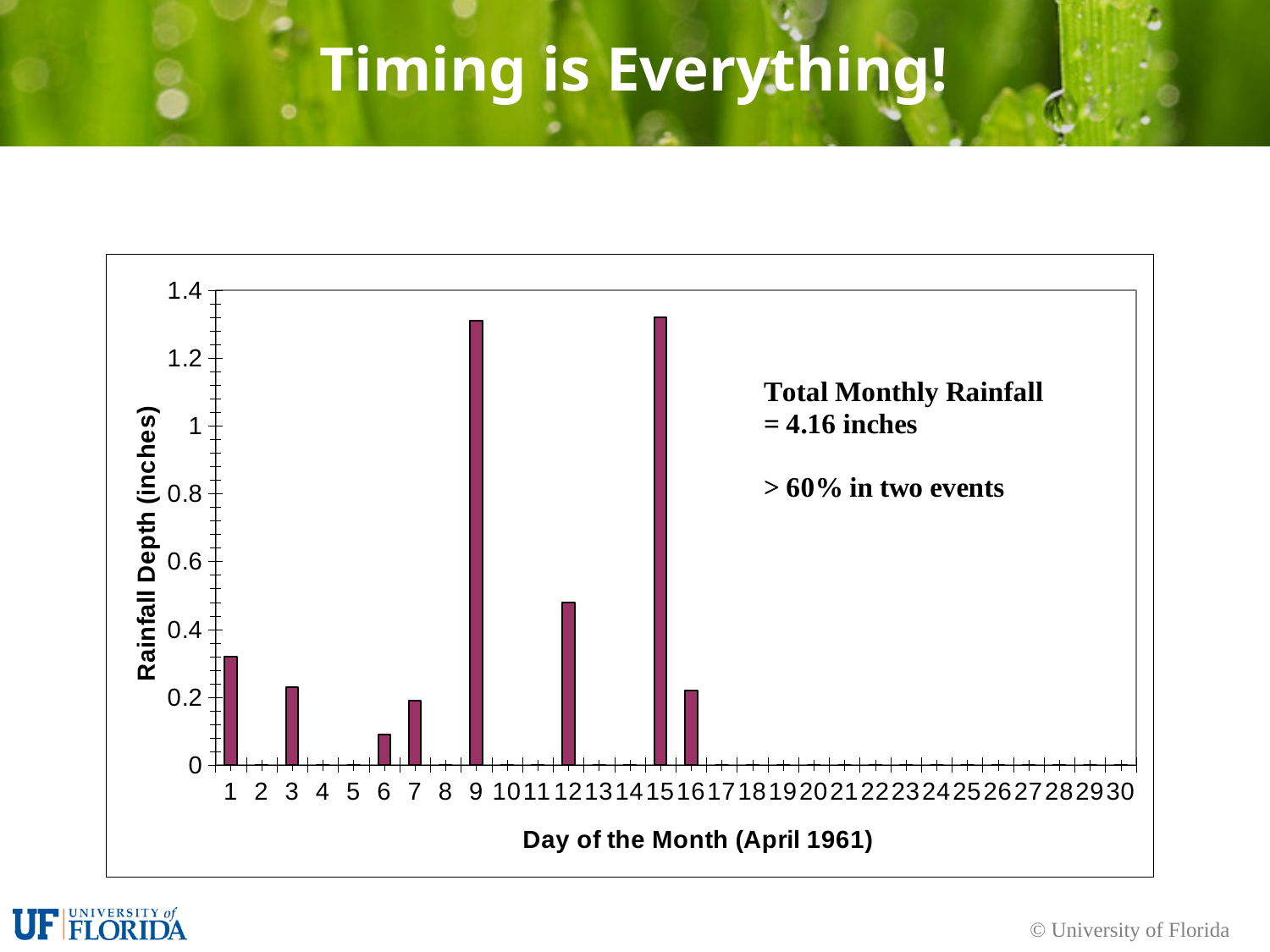
Which day has more rainfall, day 1 or day 3? day 1 Among the days with a rainfall bar, which day has the smallest rainfall depth? day 6 Is the rainfall depth for day 15 greater or less than 1 inch? greater What kind of chart is shown on the slide? bar chart How many days are shown along the x axis of the chart? 30 According to the text on the chart, what is the total monthly rainfall? 4.16 inches How many days in the chart have a rainfall bar (non-zero rainfall)? 8 Is the rainfall depth for day 12 greater or less than 0.4 inches? greater Is the rainfall depth for day 1 greater or less than 0.4 inches? less Which day has more rainfall, day 9 or day 12? day 9